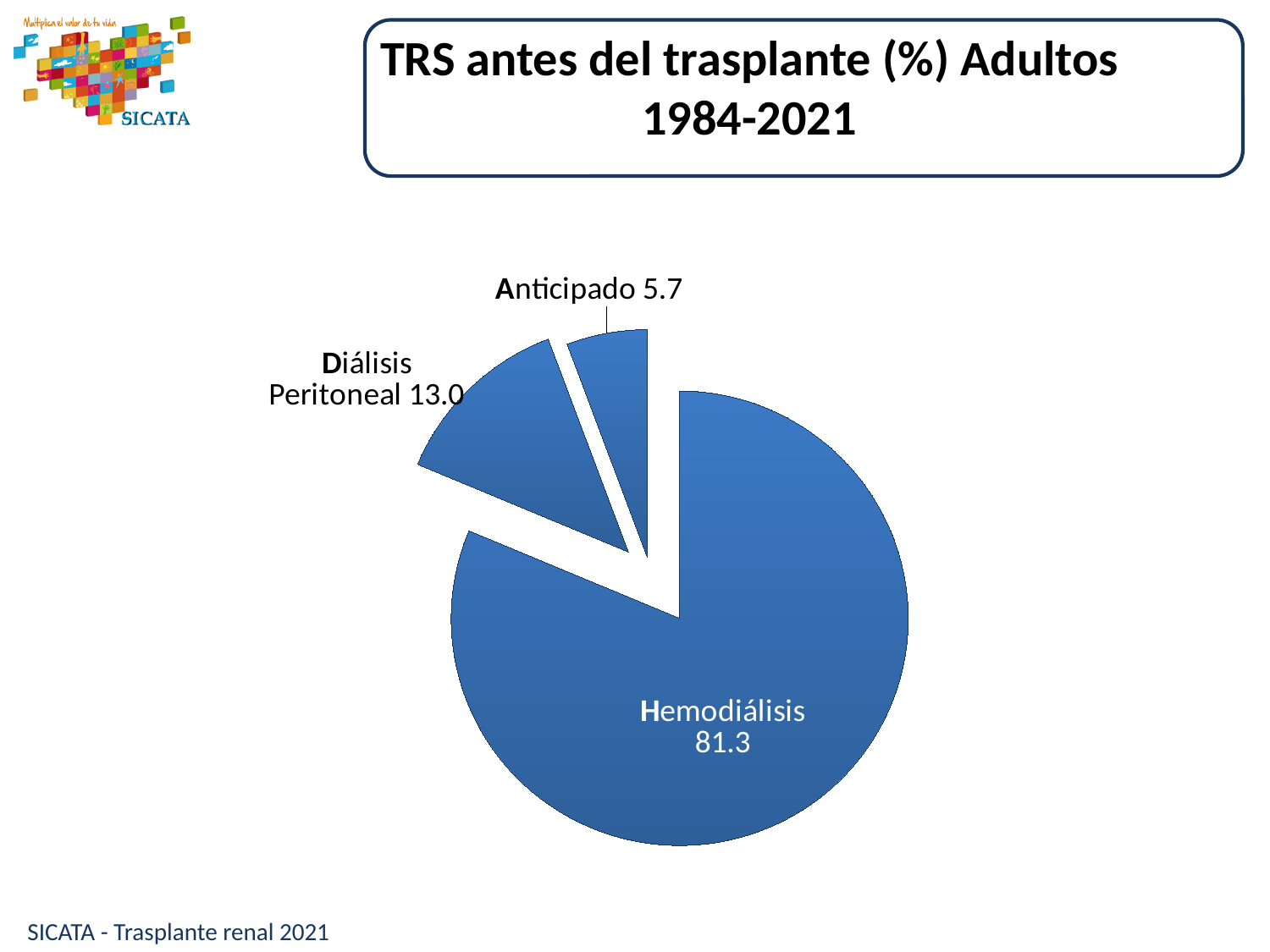
Which category has the largest slice? Hemodiálisis What is the value for Diálisis Peritoneal? 13.0 What is the title of the chart? TRS antes del trasplante (%) Adultos 1984-2021 What is the total of the three slice values shown? 100.0 What is the difference between the values for Hemodiálisis and Diálisis Peritoneal? 68.3 How many slices does the pie chart have? 3 What is the difference between the values for Diálisis Peritoneal and Anticipado? 7.3 What is the value for Anticipado? 5.7 Which category has the smallest slice? Anticipado Which is larger, Diálisis Peritoneal or Anticipado? Diálisis Peritoneal What kind of chart is shown on the slide? pie chart What is the value for Hemodiálisis? 81.3